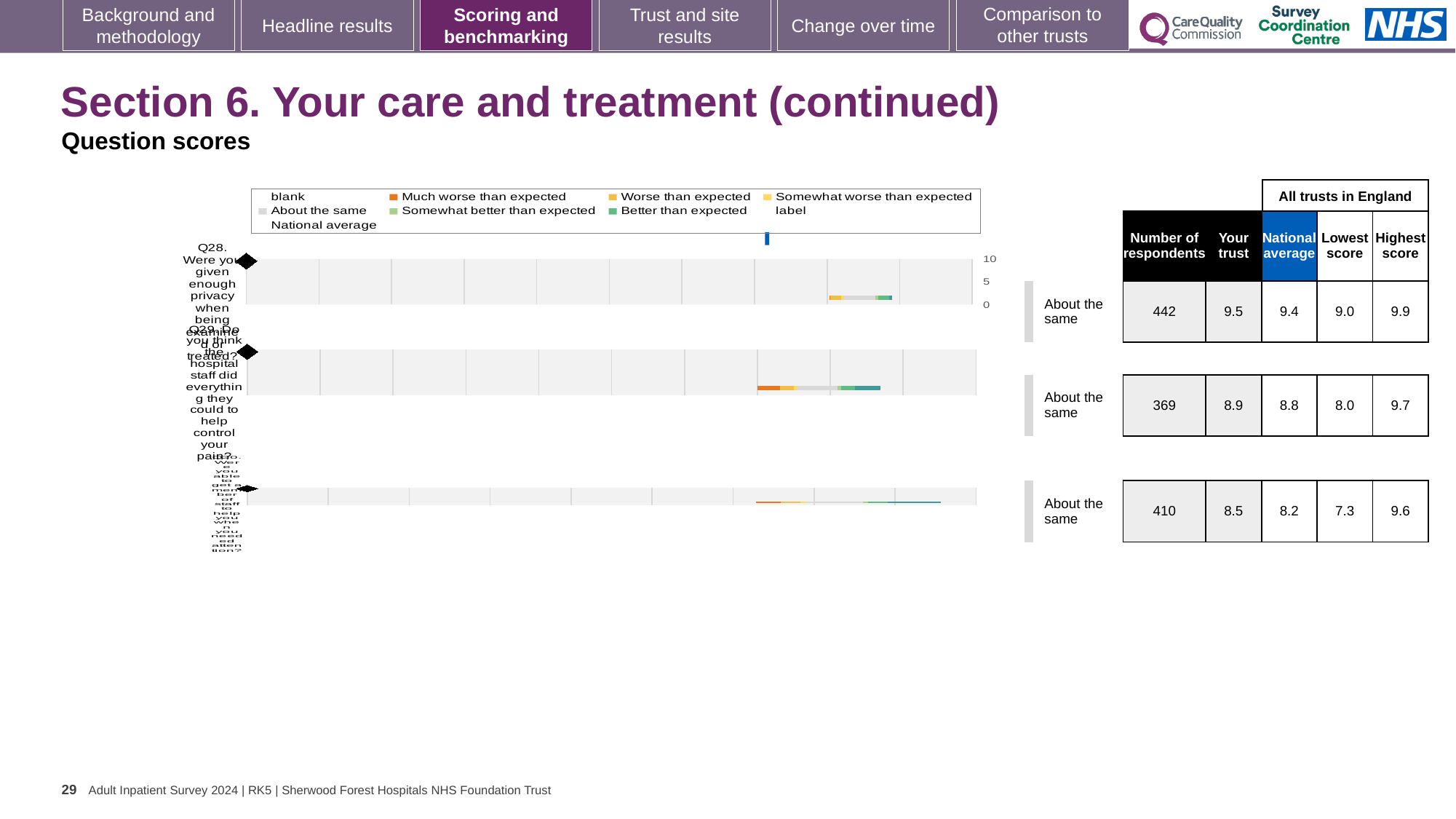
For Q28, is the trust's score higher or lower than the national average? higher Which question has the lowest 'Your trust' score on this slide? Q30 What benchmark category is shown for Q29? About the same How many respondents answered Q30 (able to get a member of staff to help when needed)? 410 For Q29, what is the difference between the highest and lowest scores among all trusts in England? 1.7 How many questions are charted on this slide? 3 Which question has the highest 'Your trust' score on this slide? Q28 For Q30, how much higher is the trust's score than the national average? 0.3 What kind of chart is used to show the question scores on this slide? bar chart What is the national average score for Q29 (staff did everything to help control pain)? 8.8 What is the 'Your trust' score for Q28 (privacy when being examined or treated)? 9.5 What is the highest score among all trusts in England for Q28? 9.9